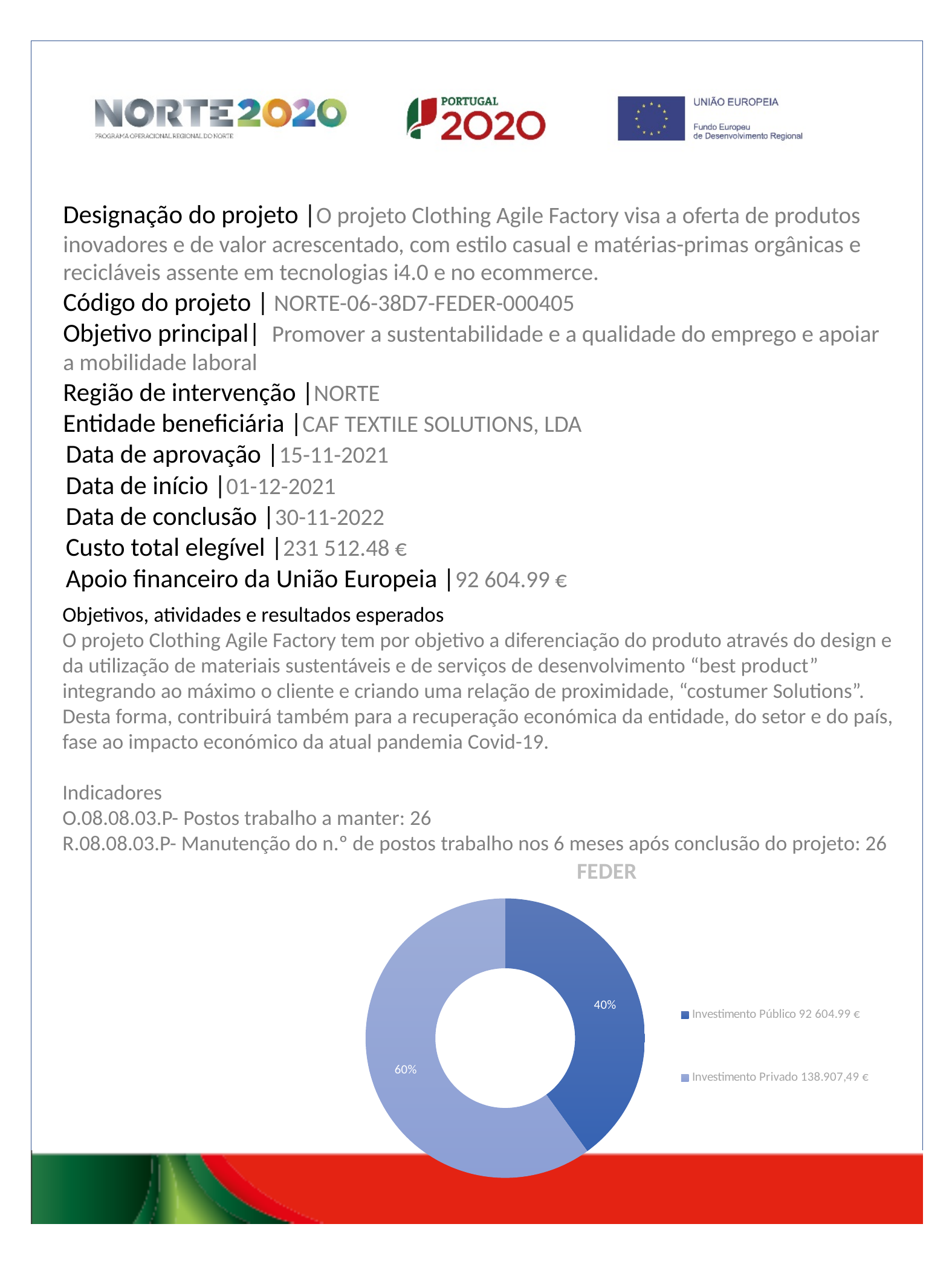
What amount is shown in the legend for Investimento Público in the FEDER chart? 92 604.99 € In the FEDER chart, which is larger: Investimento Público or Investimento Privado? Investimento Privado What is the difference in percentage points between the Investimento Privado and Investimento Público slices in the FEDER chart? 20 percentage points Which slice of the FEDER chart is the largest? Investimento Privado What kind of chart is shown under the title FEDER? doughnut chart How many slices does the FEDER chart have? 2 What amount is shown in the legend for Investimento Privado in the FEDER chart? 138.907,49 € How many entries does the legend of the FEDER chart list? 2 What share of the FEDER chart does Investimento Privado represent? 60% What share of the FEDER chart does Investimento Público represent? 40% Which slice of the FEDER chart is the smallest? Investimento Público What is the title of the chart on the slide? FEDER